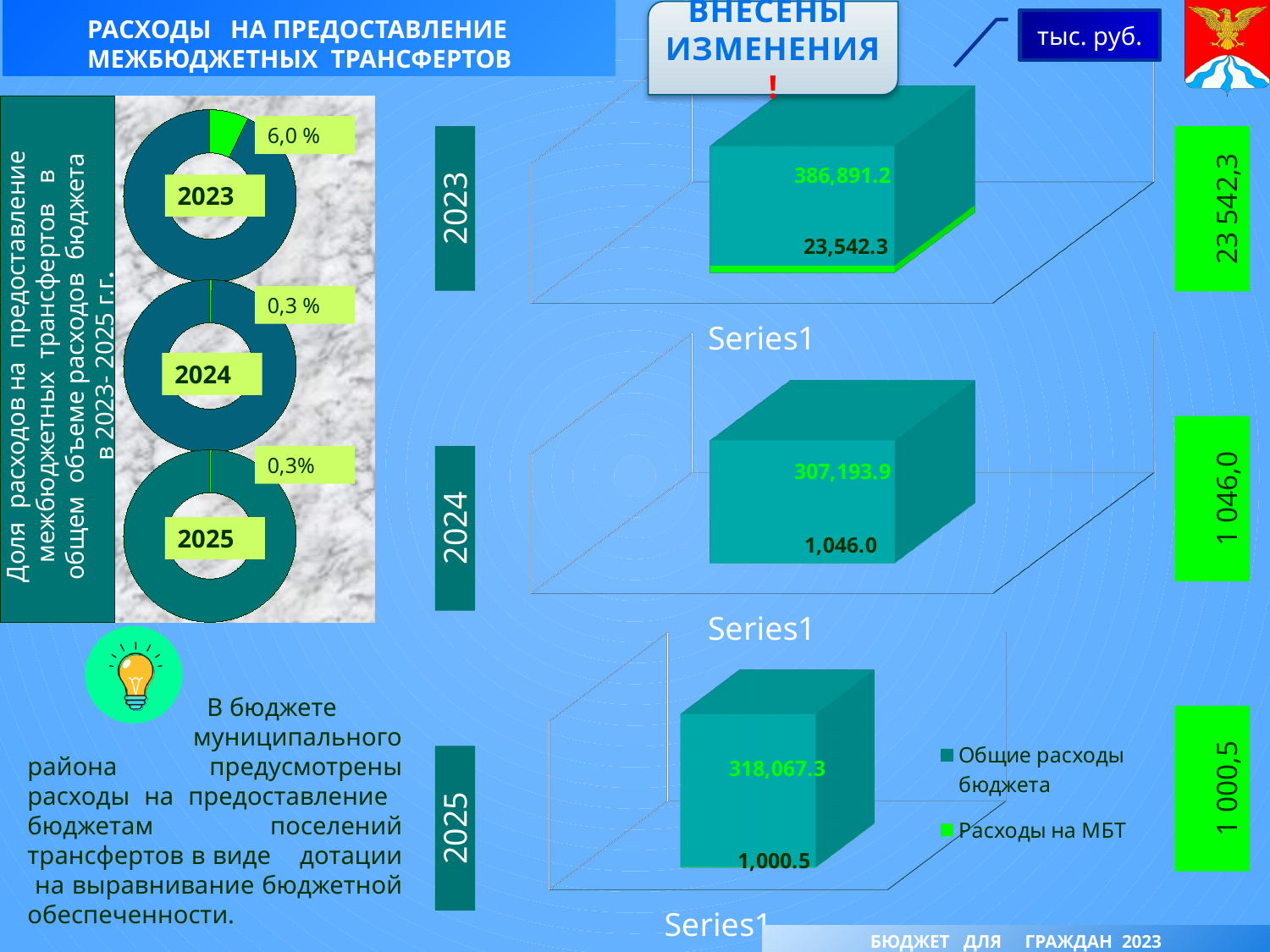
How many series does the legend of the bar charts list? 2 In the 2024 donut chart on the left, what share is shown for the green slice? 0,3 % In the 2023 bar chart, what is the value labelled for Общие расходы бюджета? 386,891.2 Across the three bar charts, which year has the highest value for Расходы на МБТ? 2023 In the 2024 bar chart, what is the value labelled for Расходы на МБТ? 1,046.0 In the 2023 bar chart, what is the value labelled for Расходы на МБТ? 23,542.3 In the 2025 bar chart, what is the value labelled for Расходы на МБТ? 1,000.5 In the 2024 bar chart, what is the value labelled for Общие расходы бюджета? 307,193.9 In the 2023 donut chart on the left, what share is shown for the green slice? 6,0 % In the 2025 bar chart, what is the value labelled for Общие расходы бюджета? 318,067.3 Across the three bar charts, which year has the lowest value for Общие расходы бюджета? 2024 What kind of chart is used for the 2023, 2024 and 2025 expense figures on the right side of the slide? Bar chart